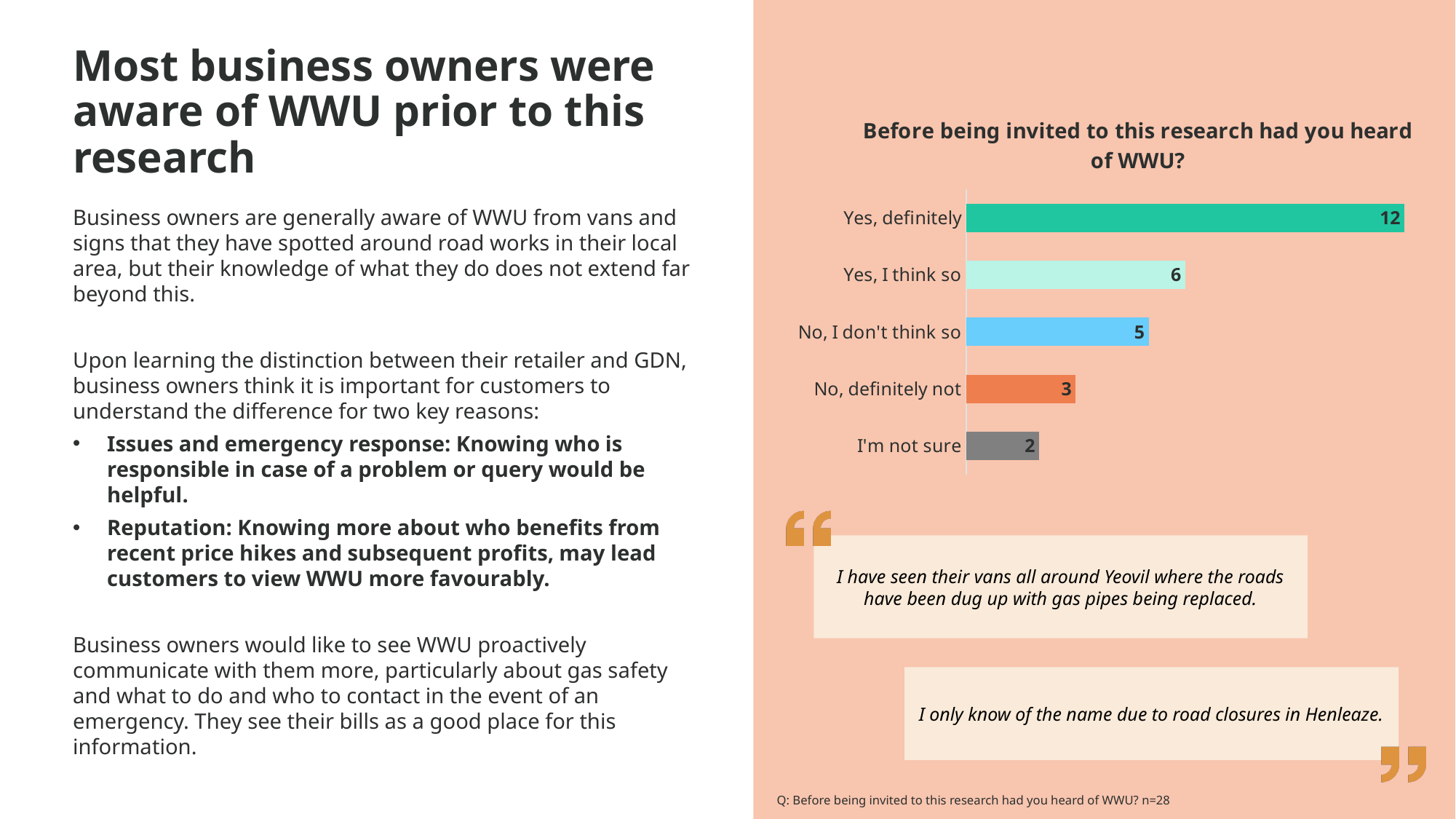
What is the difference between "No, I don't think so" and "No, definitely not"? 2 Which category has the highest value? Yes, definitely What colour is the bar for "No, definitely not"? Orange Which is larger, "Yes, I think so" or "No, definitely not"? Yes, I think so What is the value for "I'm not sure"? 2 What is the title of the chart? Before being invited to this research had you heard of WWU? What kind of chart is shown on the slide? Bar chart What is the difference between "Yes, definitely" and "Yes, I think so"? 6 What is the value for "No, I don't think so"? 5 Which category has the lowest value? I'm not sure How many categories are shown in the chart? 5 What is the value for "Yes, definitely"? 12